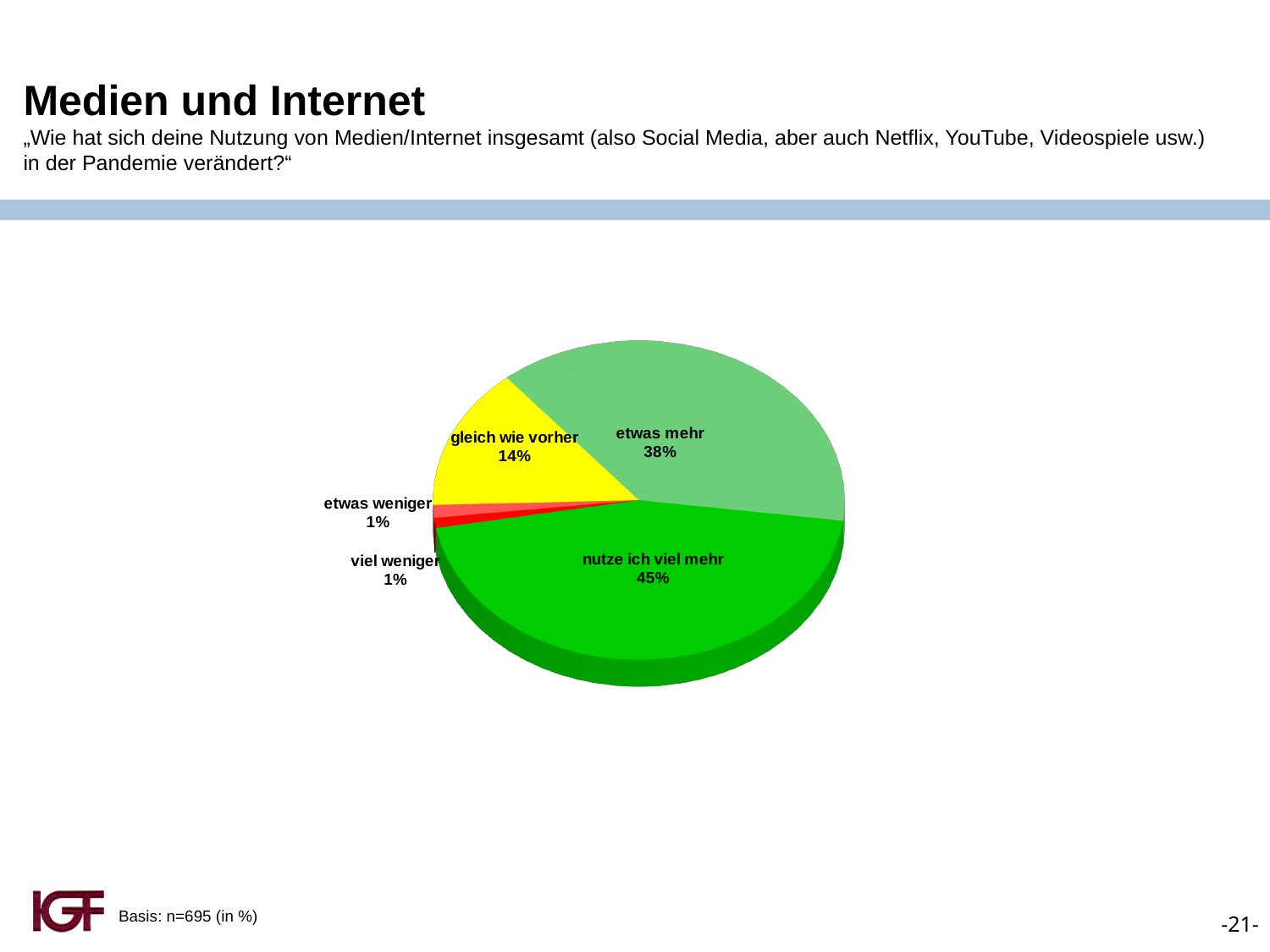
What is the difference in percentage points between "nutze ich viel mehr" and "etwas mehr"? 7 What is the difference in percentage points between "etwas mehr" and "gleich wie vorher"? 24 Which is larger, the share for "gleich wie vorher" or the share for "etwas weniger"? gleich wie vorher What is the sample size (Basis) stated on the slide? n=695 Which answer category has the largest slice of the pie? nutze ich viel mehr What share of respondents answered "etwas mehr"? 38% What share of respondents answered "gleich wie vorher"? 14% What share of respondents answered "nutze ich viel mehr"? 45% What colour is the "gleich wie vorher" slice? yellow How many slices does the pie chart have? 5 What kind of chart is shown on the slide? pie chart What share of respondents answered "etwas weniger"? 1%